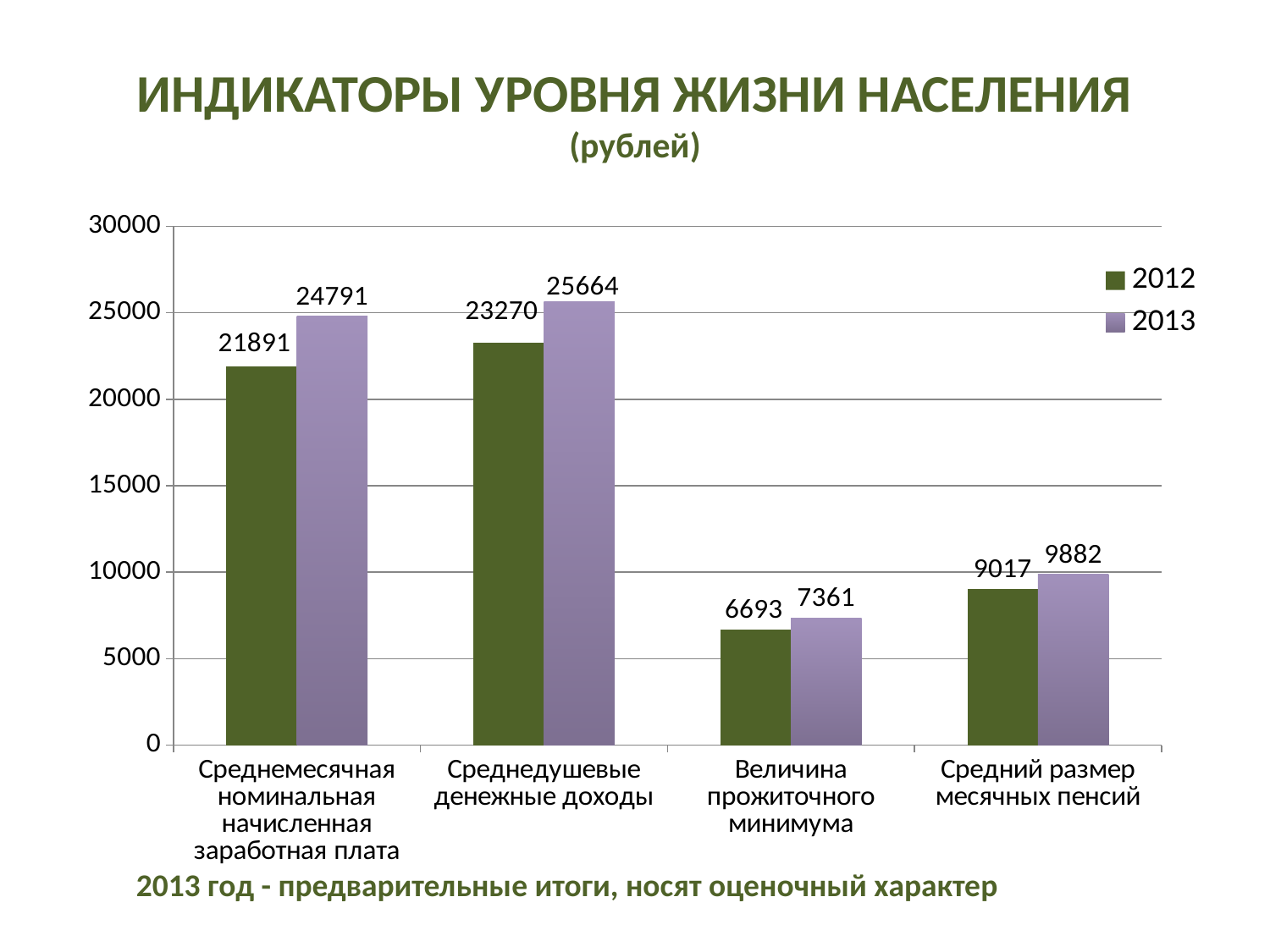
What is the 2012 value for Среднемесячная номинальная начисленная заработная плата? 21891 How many categories are shown on the x axis? 4 What kind of chart is shown on the slide? bar chart What is the difference between the 2013 and 2012 values for Среднемесячная номинальная начисленная заработная плата? 2900 Which is larger: the 2012 value for Среднедушевые денежные доходы or the 2013 value for Среднемесячная номинальная начисленная заработная плата? 2013 value for Среднемесячная номинальная начисленная заработная плата Which category has the lowest 2012 value? Величина прожиточного минимума What is the 2013 value for Среднедушевые денежные доходы? 25664 How many series does the legend list? 2 What is the 2012 value for Средний размер месячных пенсий? 9017 Which category has the highest 2013 value? Среднедушевые денежные доходы What is the 2013 value for Величина прожиточного минимума? 7361 What is the difference between the 2013 and 2012 values for Средний размер месячных пенсий? 865